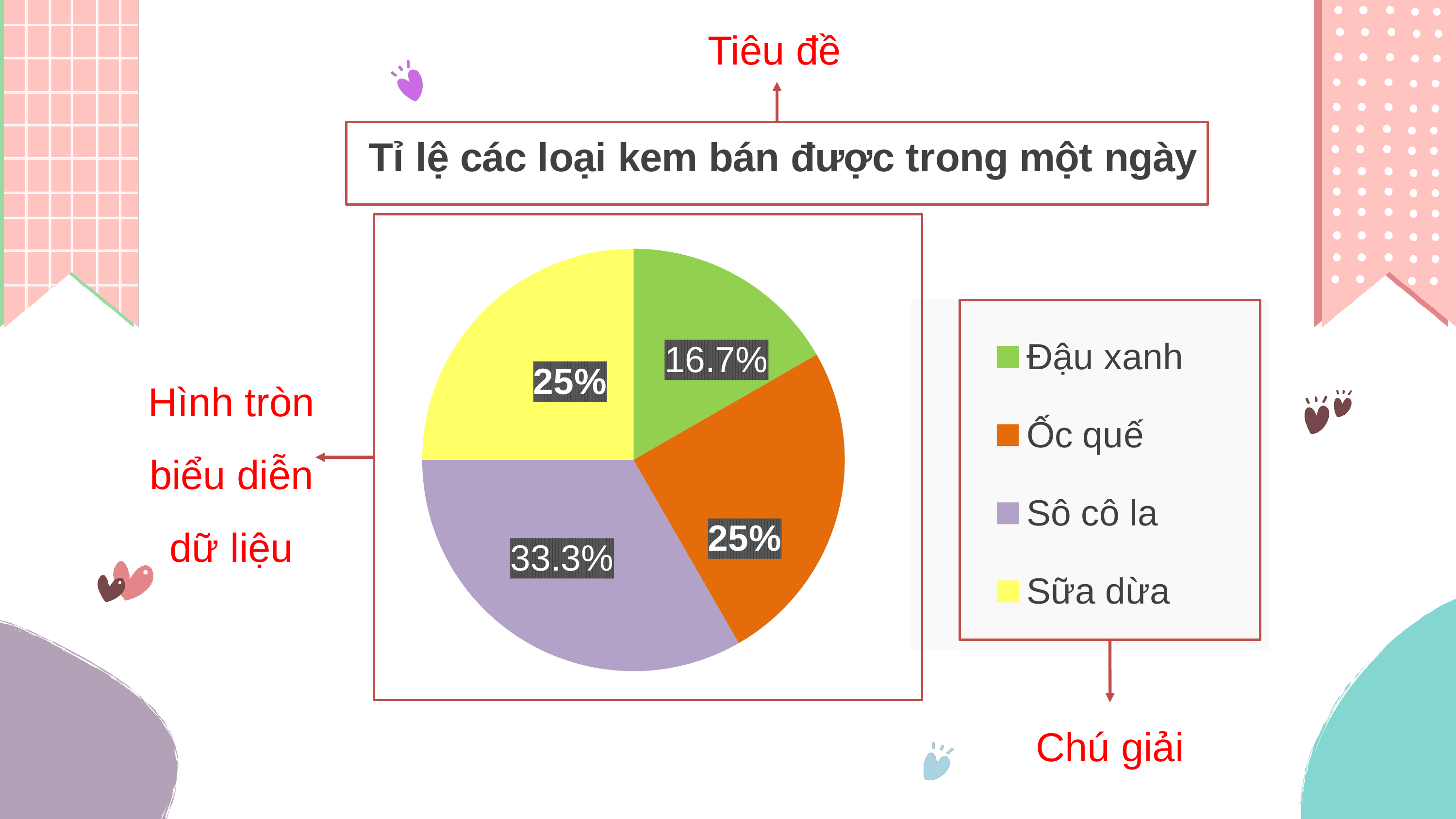
What kind of chart is shown on the slide? Pie chart Which colour represents Sữa dừa in the chart? Yellow What is the difference in percentage points between Sô cô la and Đậu xanh? 16.6 Which ice cream type has the smallest share of the pie? Đậu xanh What is the title of the chart? Tỉ lệ các loại kem bán được trong một ngày What percentage of the pie does Ốc quế represent? 25% What percentage of the pie does Đậu xanh represent? 16.7% Which ice cream type has the largest share of the pie? Sô cô la What percentage of the pie does Sô cô la represent? 33.3% How many categories does the pie chart have? 4 What percentage of the pie does Sữa dừa represent? 25% Which has a larger share, Ốc quế or Đậu xanh? Ốc quế